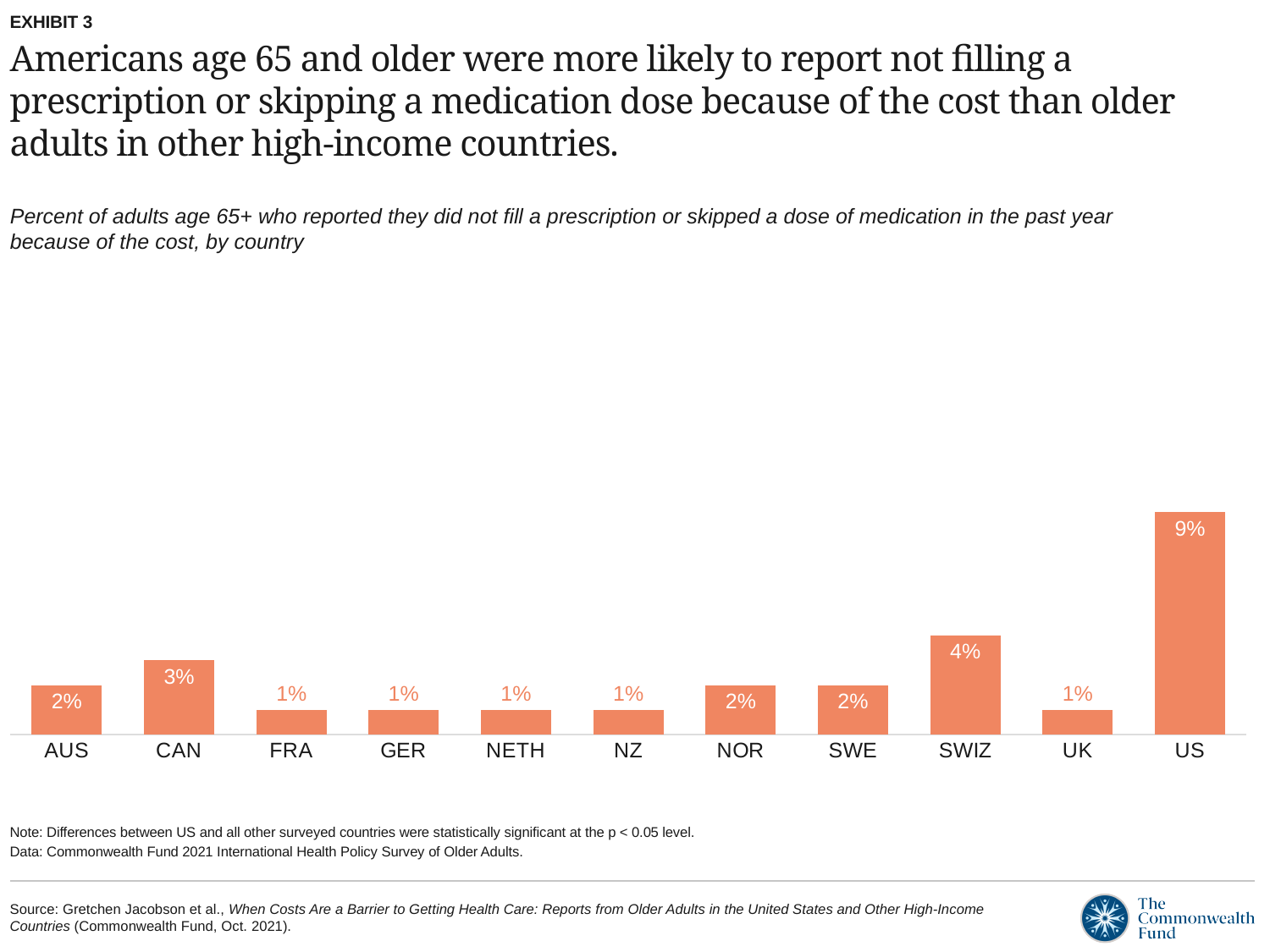
What is the value for NETH? 1% What is the difference between the values for CAN and AUS? 1% Which is larger, the value for NOR or the value for UK? NOR What is the difference between the values for the US and SWIZ? 5% What is the value for the US? 9% How many countries are shown in the chart? 11 Which country has the highest value? US Which is larger, the value for SWIZ or the value for CAN? SWIZ What is the value for SWIZ? 4% What is the value for CAN? 3% How many countries have a value of 1%? 5 What kind of chart is shown on the slide? Bar chart